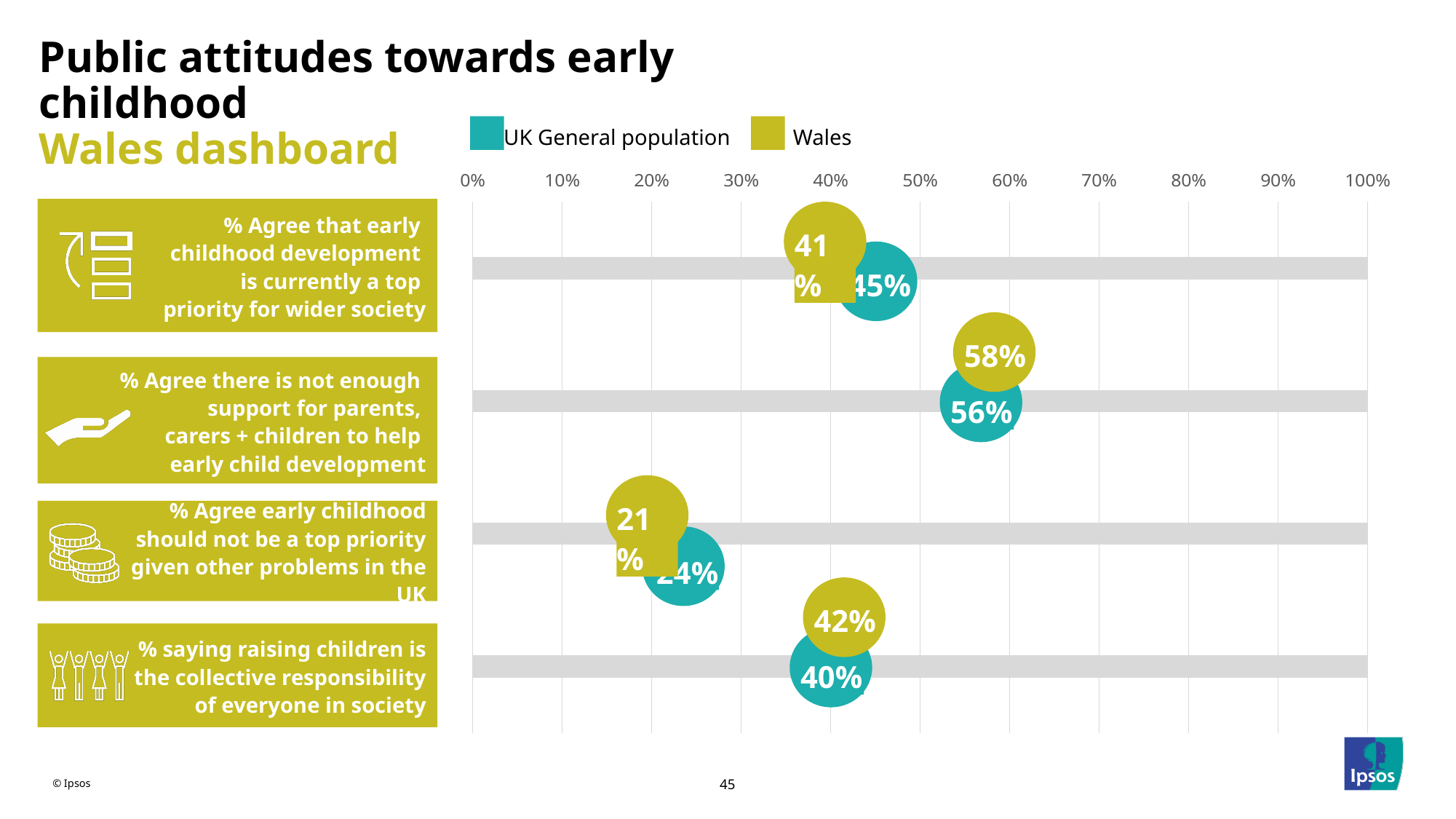
For the statement that raising children is the collective responsibility of everyone in society, which is higher: Wales or the UK General population? Wales Which statement has the highest value for Wales? % Agree there is not enough support for parents, carers + children to help early child development What percentage of the UK General population say raising children is the collective responsibility of everyone in society? 40% What percentage of the Wales sample agree early childhood should not be a top priority given other problems in the UK? 21% What percentage of the Wales sample agree that early childhood development is currently a top priority for wider society? 41% Is the Wales value for agreeing there is not enough support for parents, carers and children greater or less than 50%? greater Which statement has the lowest value for the UK General population? % Agree early childhood should not be a top priority given other problems in the UK How many series does the legend list? 2 Which colour represents Wales in the chart? Yellow What percentage of the UK General population agree there is not enough support for parents, carers and children to help early child development? 56% How many statements are plotted on the chart? 4 What is the difference between the UK General population and Wales values for agreeing that early childhood development is currently a top priority for wider society? 4 percentage points